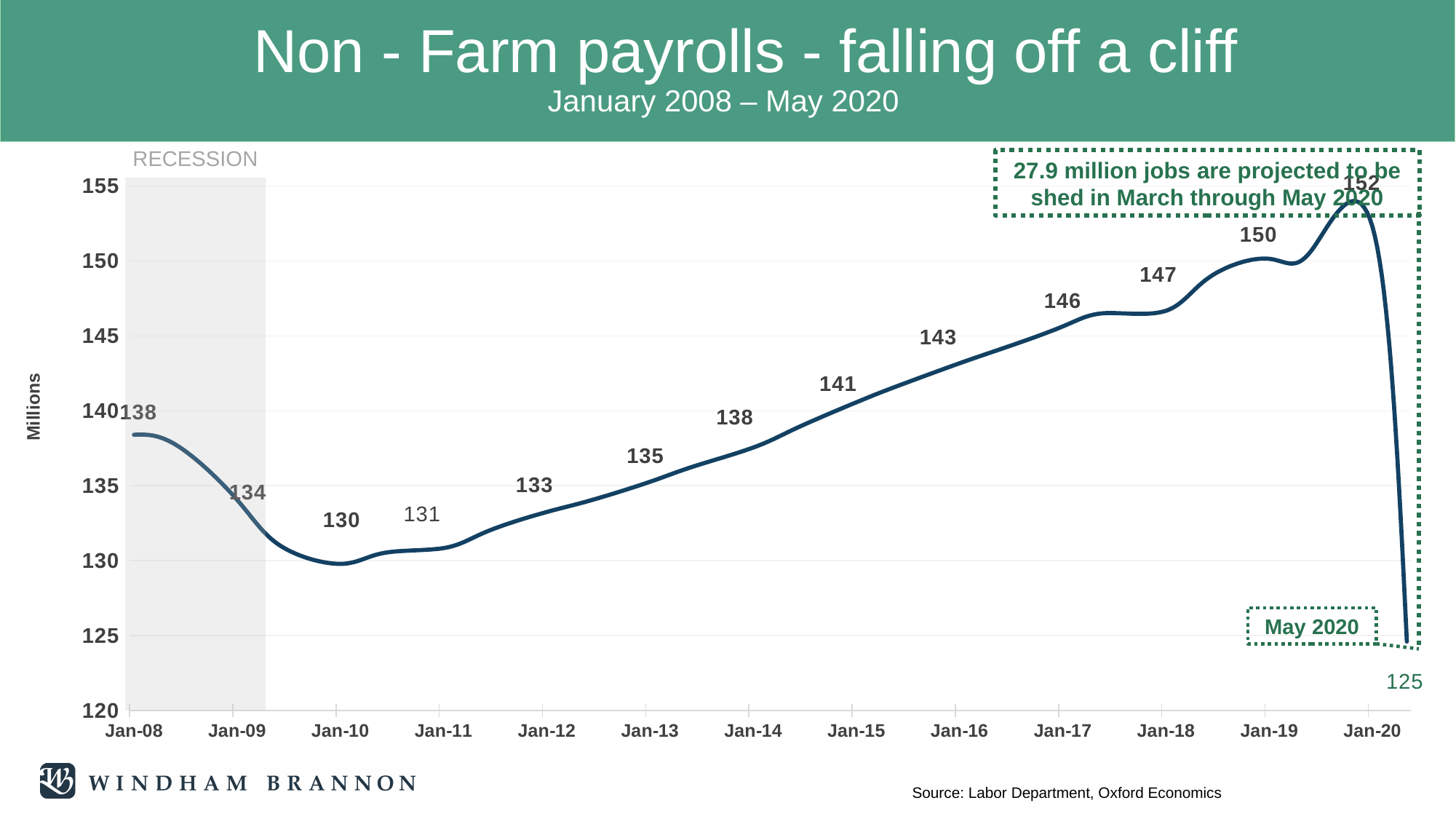
Which labelled point has the lowest value? May 2020 What is the value labelled for May 2020? 125 What is the value for Jan-10? 130 What is the unit shown on the vertical axis label? Millions What is the value for Jan-20? 152 Does the line rise or fall between Jan-10 and Jan-20? rise What is the value for Jan-17? 146 What type of chart is shown on the slide? line chart What is the difference between the values for Jan-20 and May 2020? 27 Which labelled point has the highest value? Jan-20 Which is larger, the value for Jan-14 or the value for Jan-09? Jan-14 What is the value for Jan-08? 138